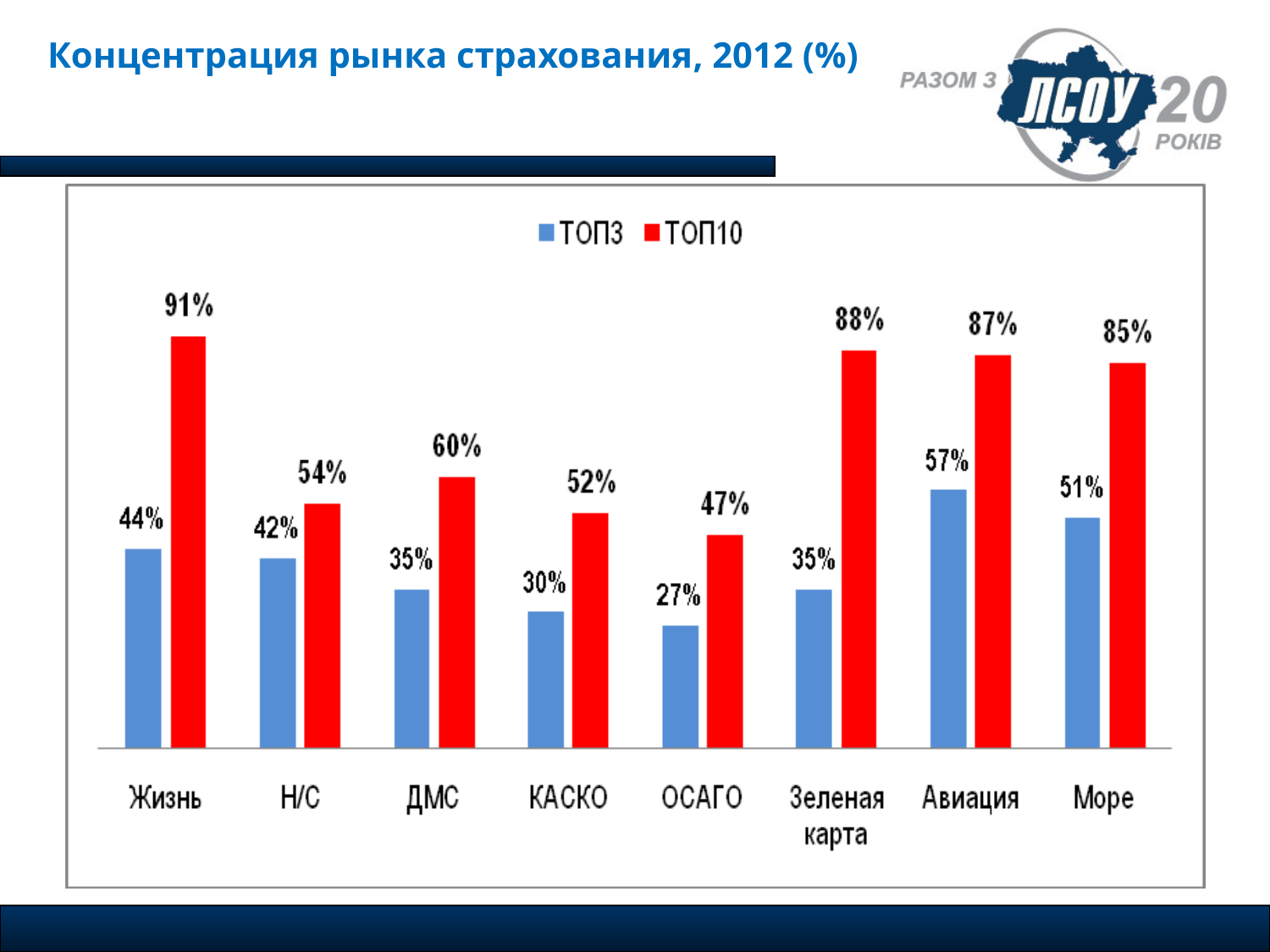
What is the difference between the ТОП10 values for Зеленая карта and Море? 3% What is the ТОП10 value for Жизнь? 91% What is the ТОП3 value for ОСАГО? 27% Which category has the lowest ТОП3 value? ОСАГО What kind of chart is shown on the slide? Bar chart Which category has the highest ТОП10 value? Жизнь What is the difference between the ТОП10 and ТОП3 values for Жизнь? 47% What is the ТОП3 value for Авиация? 57% How many series does the legend list? 2 How many categories are shown on the x axis? 8 Which colour represents the ТОП10 series? Red Which is larger, the ТОП3 value for Авиация or the ТОП3 value for Море? Авиация